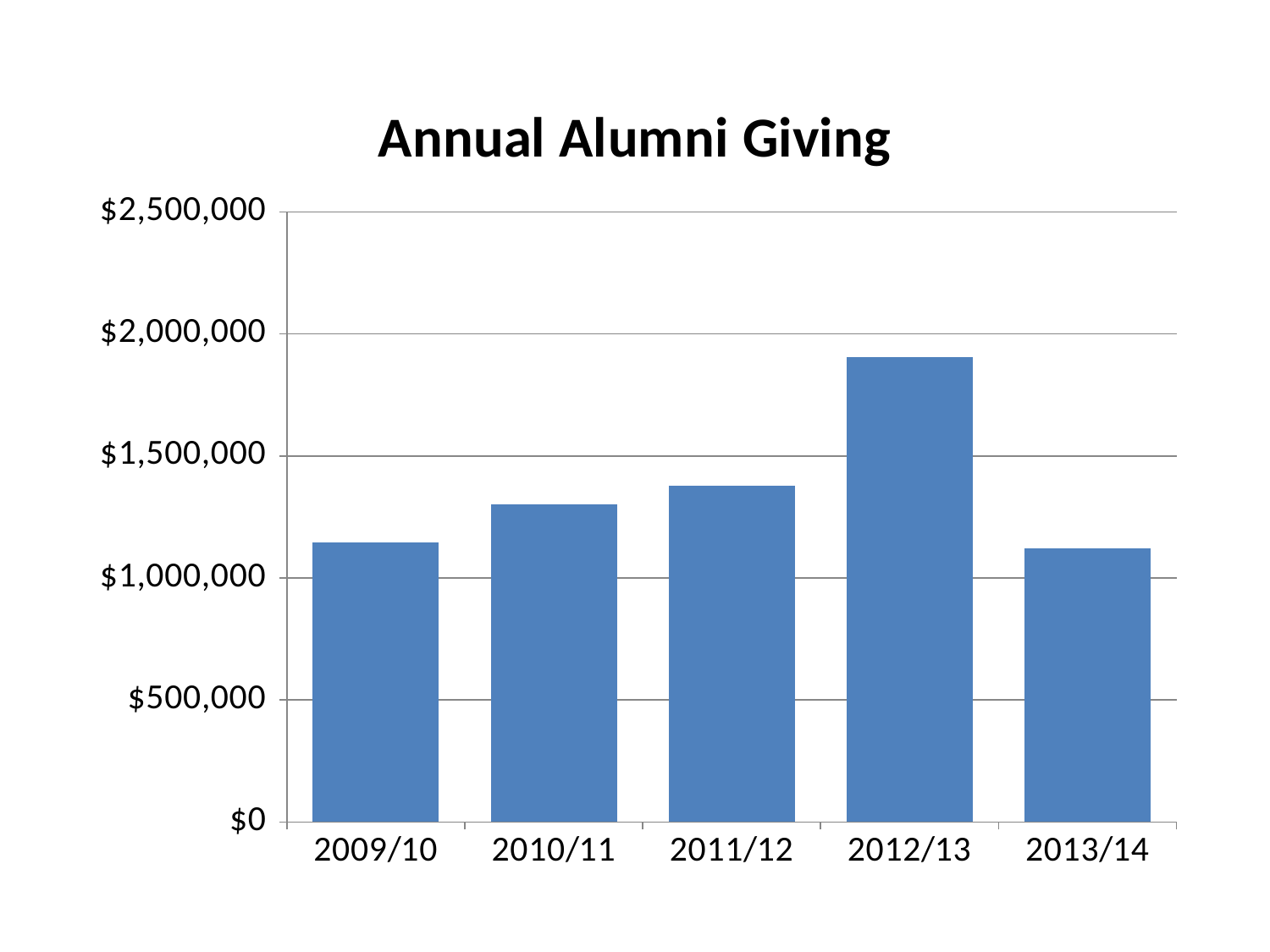
Is the value for 2011/12 greater or less than $1,500,000? less Which year has the highest annual alumni giving? 2012/13 Is the value for 2013/14 greater or less than $1,500,000? less Is the value for 2012/13 greater or less than $1,500,000? greater Which is larger, the value for 2012/13 or the value for 2013/14? 2012/13 What type of chart is shown on the slide? bar chart How many years are shown on the x axis of the chart? 5 What is the title of the chart? Annual Alumni Giving Do the values rise or fall from 2009/10 to 2012/13? rise Which is larger, the value for 2009/10 or the value for 2011/12? 2011/12